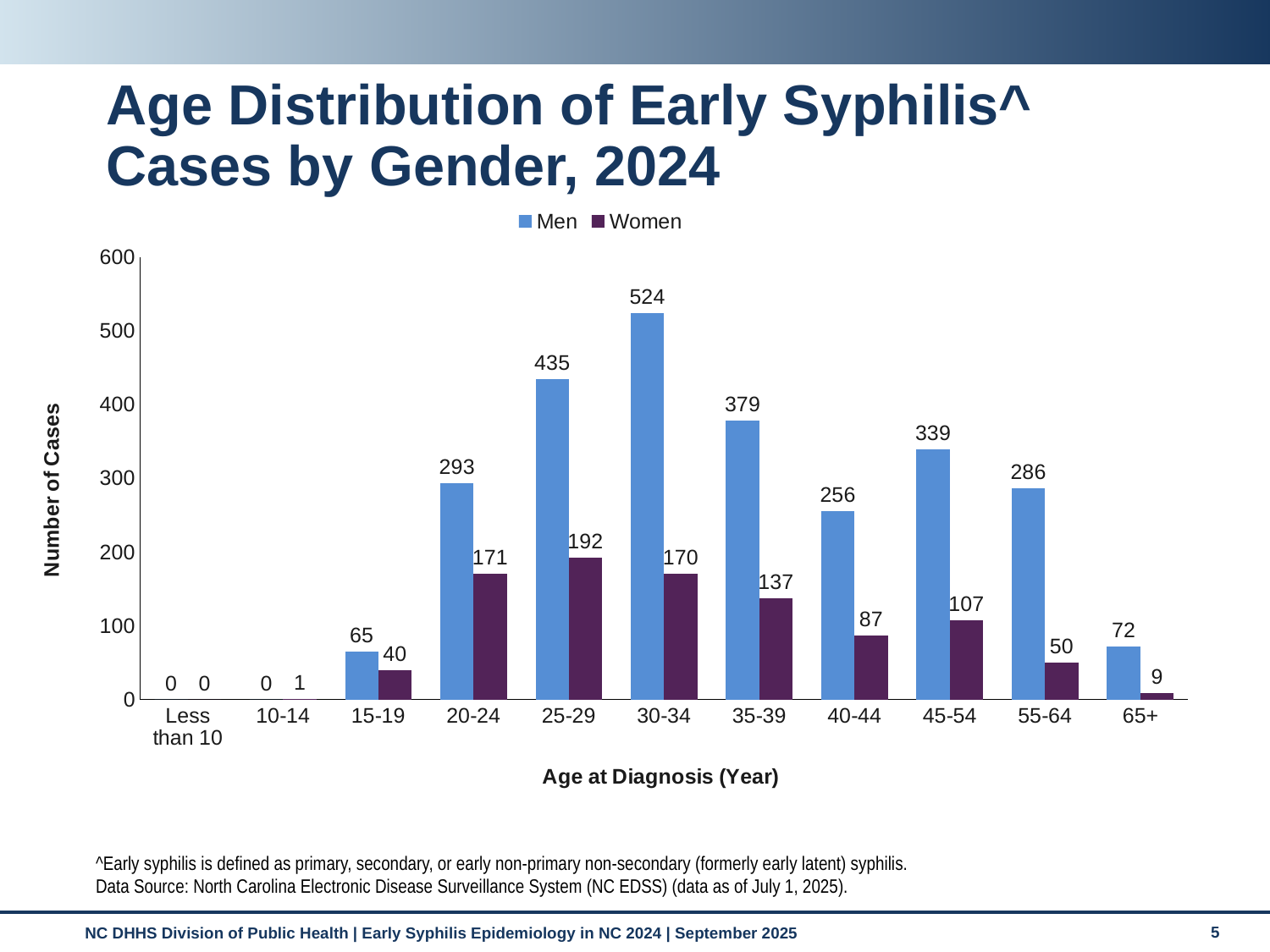
Which age group has the highest number of cases among women? 25-29 What is the difference between the number of cases for men and women in the 35-39 age group? 242 How many early syphilis cases were there among men aged 30-34? 524 What is the label of the y axis? Number of Cases Is the value for men aged 20-24 greater or less than 300? less Which is larger, the number of cases for men aged 45-54 or men aged 55-64? Men aged 45-54 How many series does the legend list? 2 Which age group has the highest number of cases among men? 30-34 What kind of chart is shown on the slide? Bar chart How many age groups are shown on the x axis? 11 How many early syphilis cases were there among women aged 25-29? 192 What is the total number of cases (men plus women) in the 40-44 age group? 343